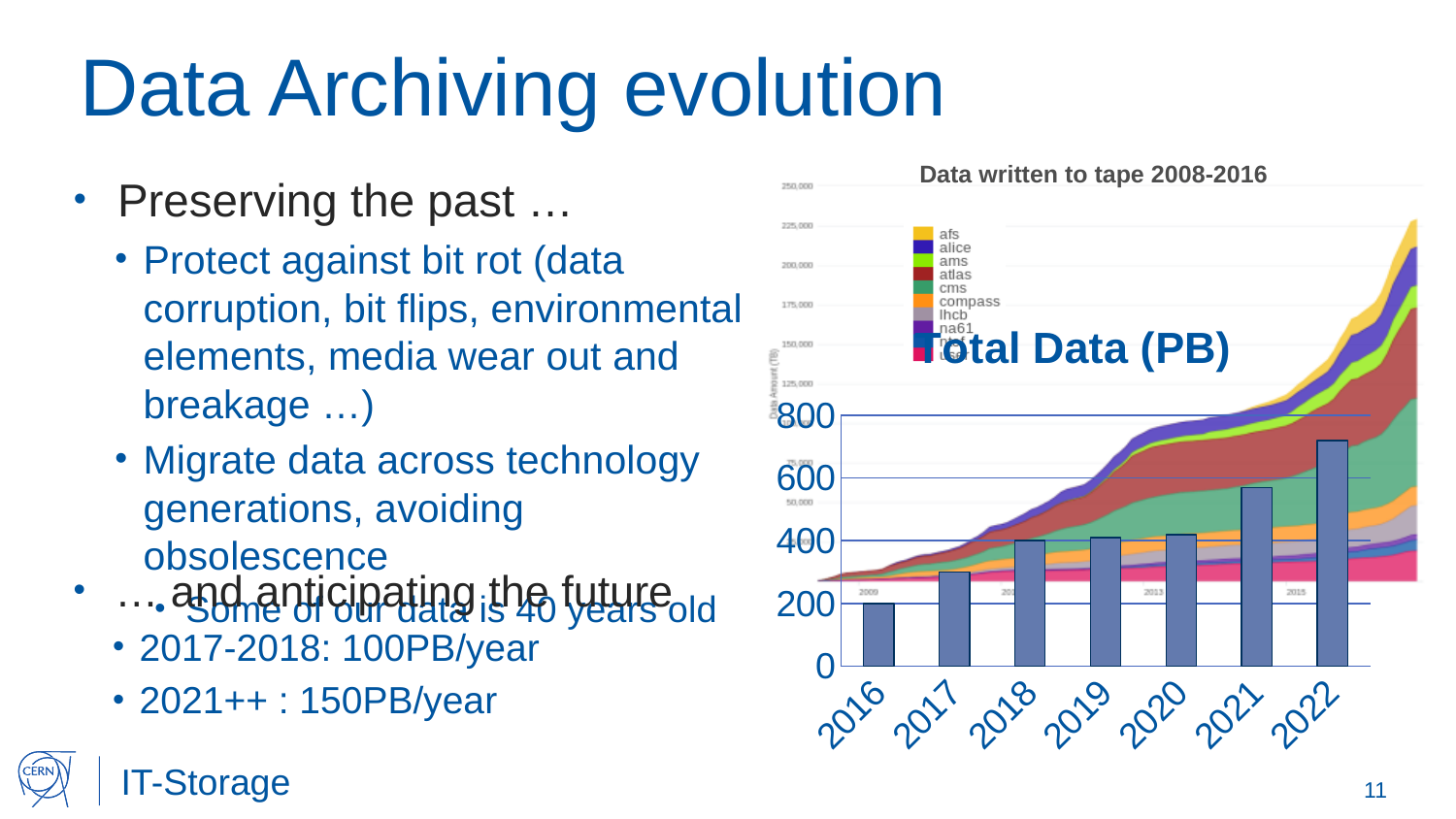
In the 'Total Data (PB)' chart, which year has the larger value, 2018 or 2021? 2021 In the 'Total Data (PB)' chart, is the value for 2019 greater or less than 600? less In the 'Total Data (PB)' chart, is the value for 2021 greater or less than 600? less In the 'Total Data (PB)' chart, do the values generally rise or fall from 2016 to 2022? rise In the 'Total Data (PB)' chart, which year has the lowest bar? 2016 In the 'Total Data (PB)' chart, which year has the highest bar? 2022 In the 'Total Data (PB)' chart, is the value for 2022 greater or less than 600? greater In the 'Data written to tape 2008-2016' chart, what is the first entry listed in the legend? afs What is the title of the chart in the background on the right side of the slide? Data written to tape 2008-2016 How many years are shown on the x axis of the 'Total Data (PB)' chart? 7 What kind of chart is the 'Total Data (PB)' chart? bar chart